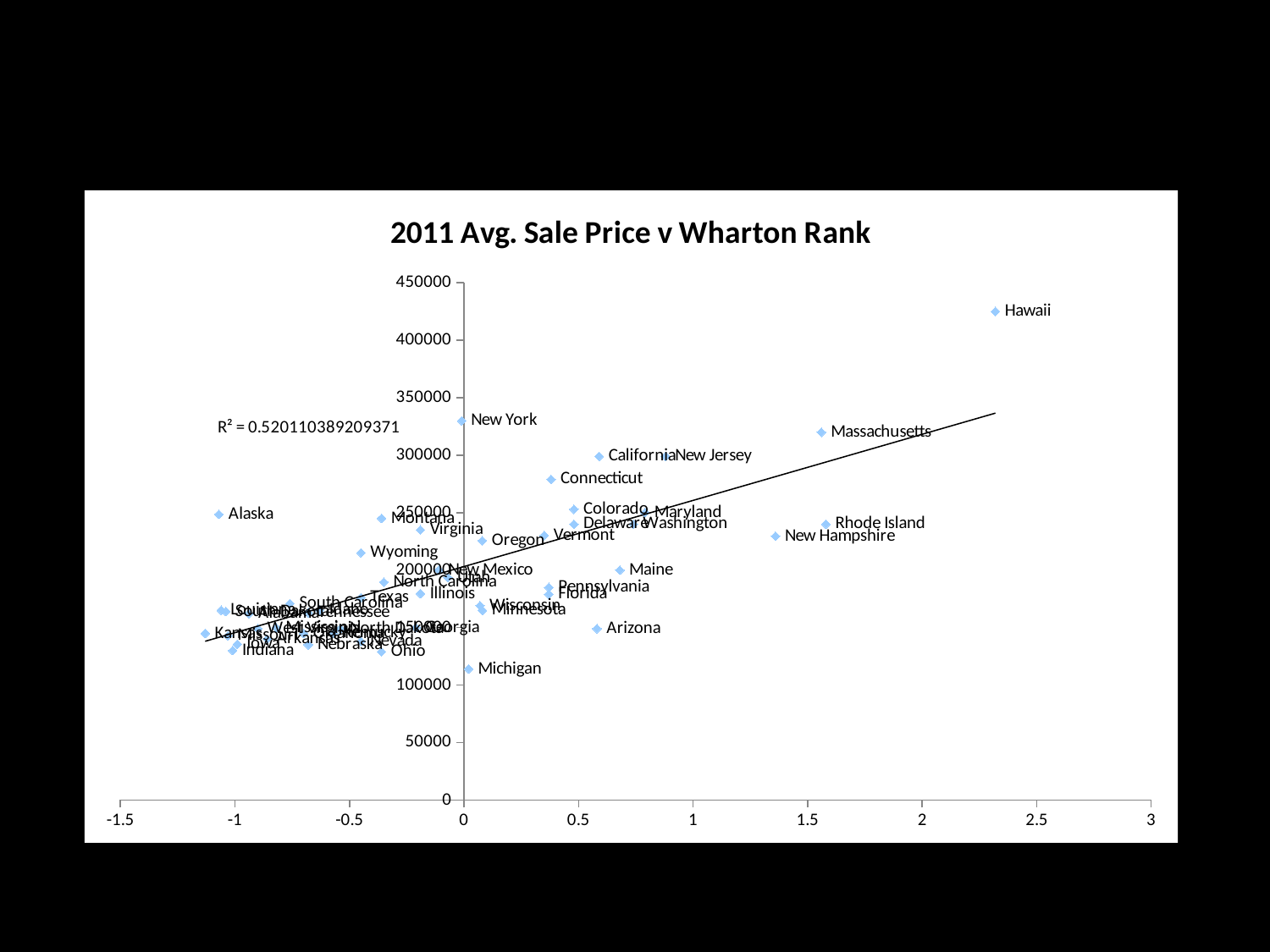
Is the value for Rhode Island greater or less than 250000? less Does the trendline show average sale price rising or falling as Wharton Rank increases? Rising Is the value for Hawaii greater or less than 400000? greater What R² value is printed on the chart? R² = 0.520110389209371 Which state has the highest average sale price on the chart? Hawaii Is the value for New York greater or less than 300000? greater Which has a higher average sale price, New York or California? New York Which state has the lowest average sale price on the chart? Michigan What is the title of the chart? 2011 Avg. Sale Price v Wharton Rank What type of chart is shown on the slide? Scatter chart Which has a higher average sale price, Hawaii or Massachusetts? Hawaii